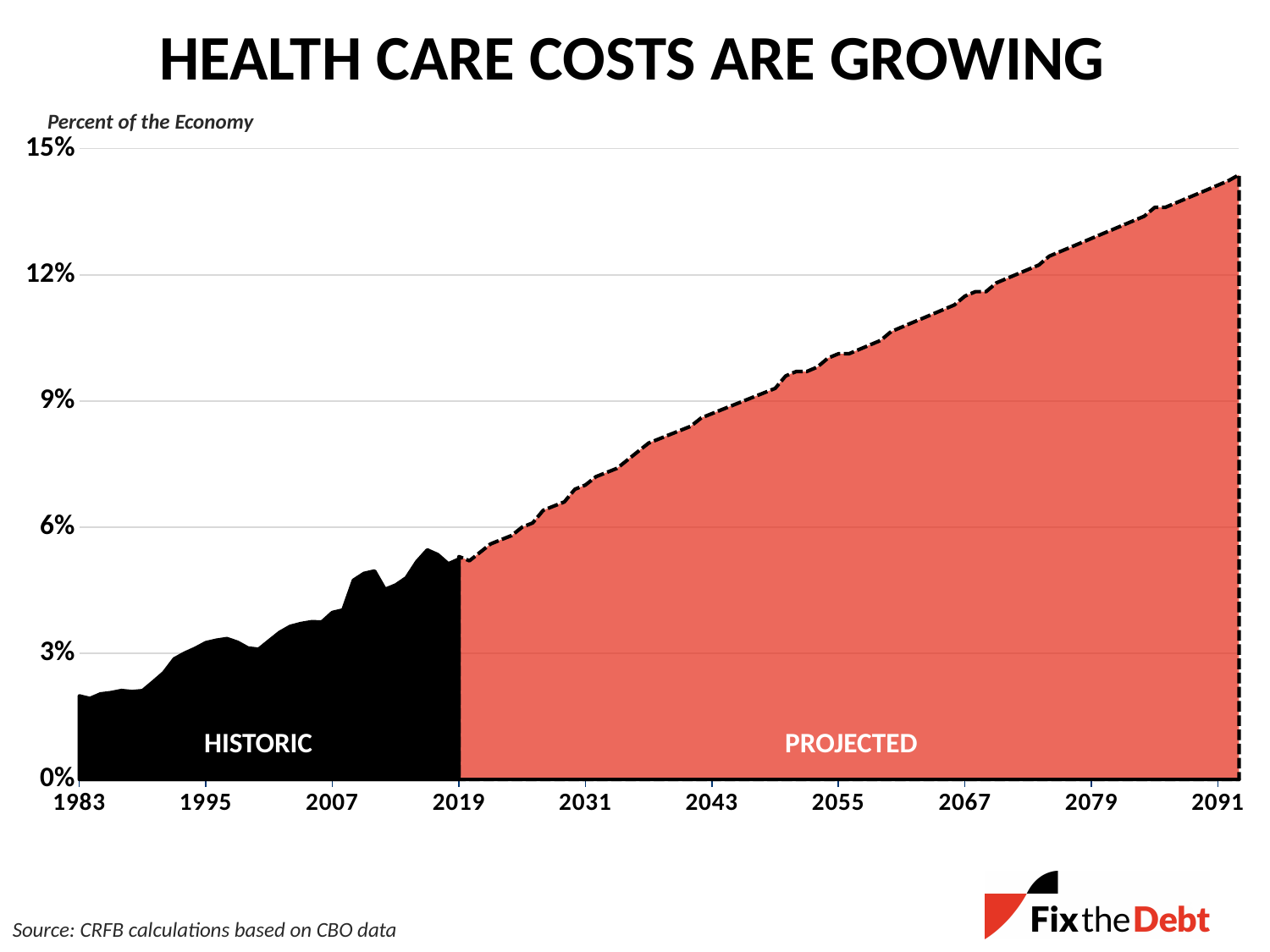
Is the value for 1983 greater or less than 3%? less Is the value for 2091 greater or less than 12%? greater Is the value for 2055 greater or less than 9%? greater Do health care costs as a percent of the economy rise or fall from 1983 to 2091? Rise What kind of chart is shown on the slide? Area chart Which year has a higher value, 2031 or 2079? 2079 What is the title of the chart? HEALTH CARE COSTS ARE GROWING What unit does the vertical axis measure, according to the axis label? Percent of the Economy